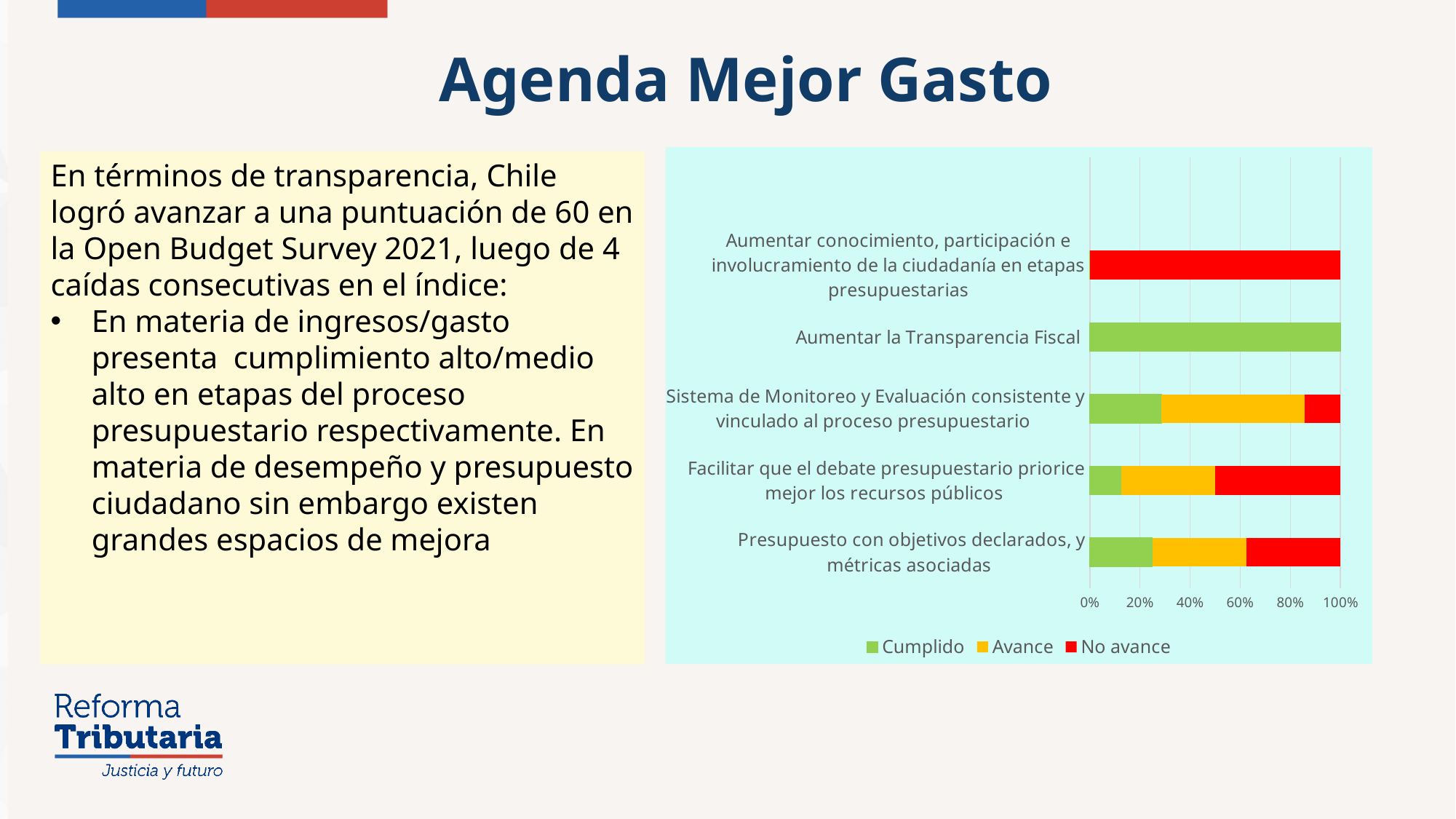
Which category has the highest Cumplido share? Aumentar la Transparencia Fiscal What kind of chart is shown on the slide? Stacked bar chart Is the Cumplido value for 'Sistema de Monitoreo y Evaluación consistente y vinculado al proceso presupuestario' greater or less than 40%? less How many series does the chart legend list? 3 Which has a larger Cumplido share: 'Sistema de Monitoreo y Evaluación consistente y vinculado al proceso presupuestario' or 'Facilitar que el debate presupuestario priorice mejor los recursos públicos'? Sistema de Monitoreo y Evaluación consistente y vinculado al proceso presupuestario What is the Cumplido value for 'Aumentar la Transparencia Fiscal'? 100% Which series is shown in red in the chart? No avance What is the No avance value for 'Aumentar conocimiento, participación e involucramiento de la ciudadanía en etapas presupuestarias'? 100% What are the series names listed in the chart legend? Cumplido, Avance, No avance Is the Cumplido value for 'Facilitar que el debate presupuestario priorice mejor los recursos públicos' greater or less than 20%? less Which category has the highest No avance share? Aumentar conocimiento, participación e involucramiento de la ciudadanía en etapas presupuestarias How many categories are plotted in the chart? 5